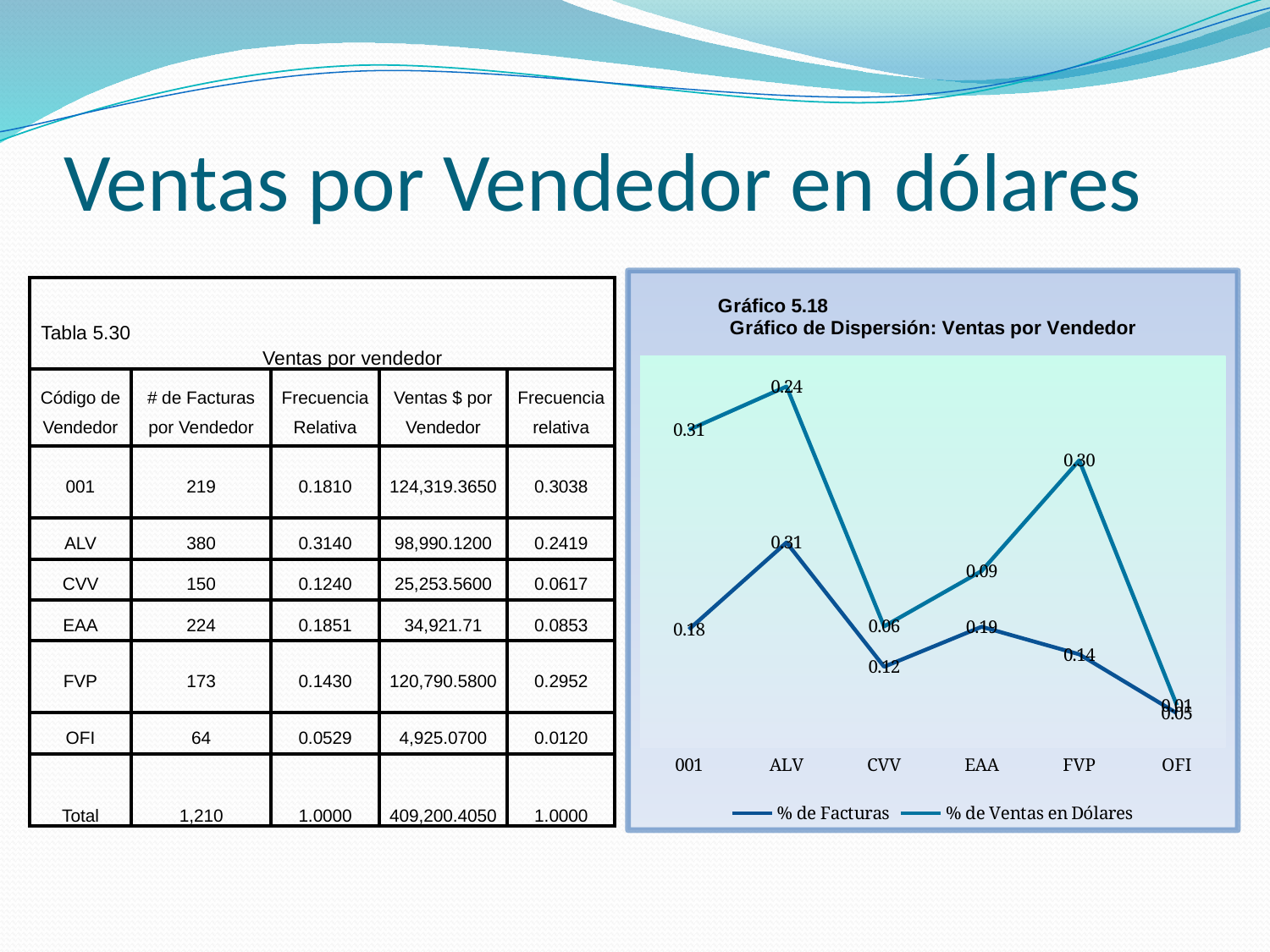
What is the % de Facturas value for ALV? 0.31 What is the difference between % de Facturas and % de Ventas en Dólares for ALV? 0.07 What kind of chart is shown on the slide? Line chart How many vendor codes are shown on the x axis of the chart? 6 Which vendor has the lowest % de Ventas en Dólares? OFI Which vendor has the highest % de Facturas? ALV What is the % de Facturas value for EAA? 0.19 For CVV, which is larger: % de Facturas or % de Ventas en Dólares? % de Facturas Does the % de Ventas en Dólares series rise or fall from CVV to FVP? Rise What is the % de Ventas en Dólares value for FVP? 0.30 What is the % de Ventas en Dólares value for 001? 0.31 How many series does the chart legend list? 2